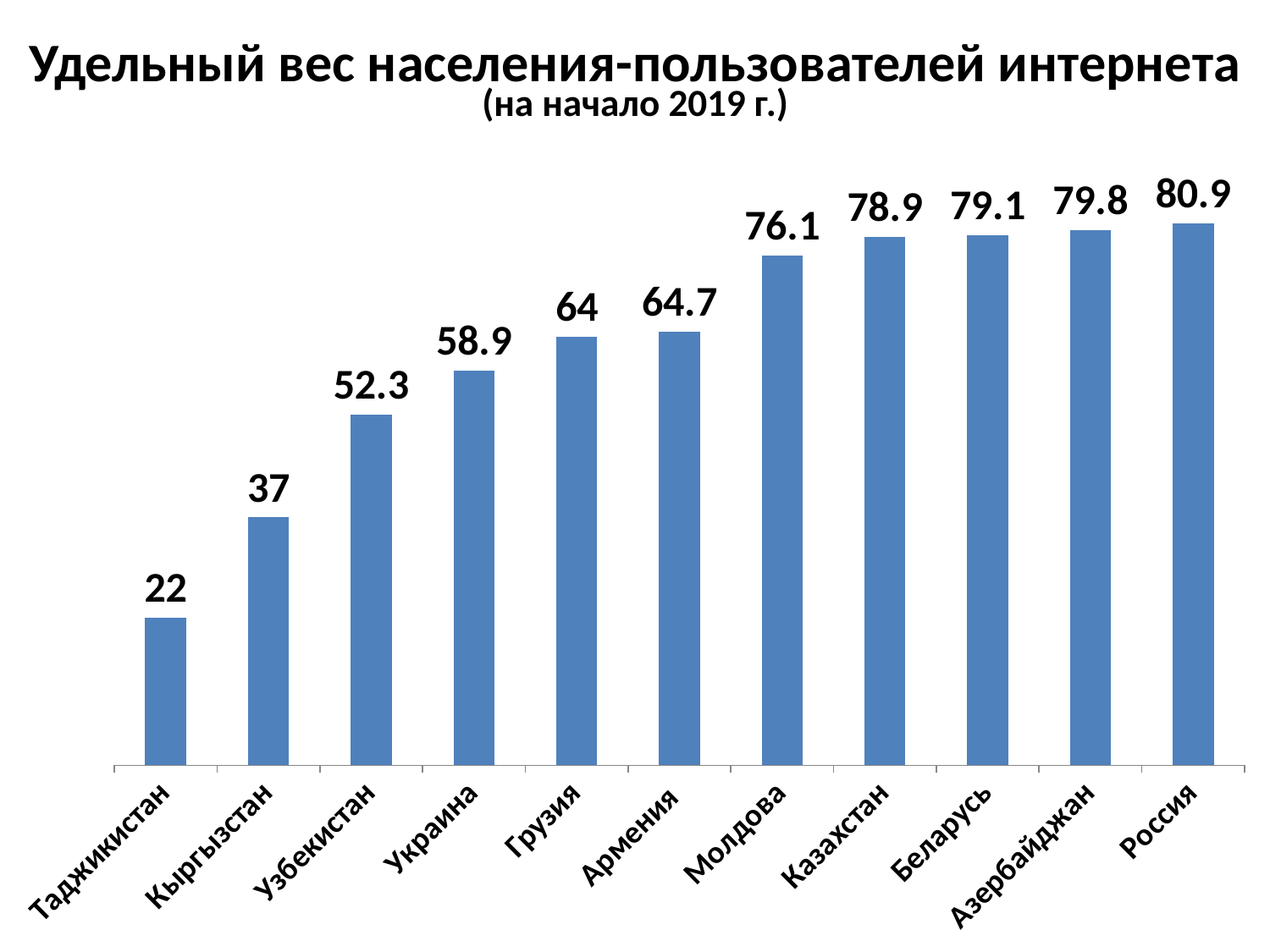
Which country has the lowest value? Таджикистан What is the difference between the values for Кыргызстан and Таджикистан? 15 What is the value for Узбекистан? 52.3 Which is larger, the value for Украина or the value for Грузия? Грузия What is the value for Армения? 64.7 What is the difference between the values for Россия and Молдова? 4.8 Which country has the highest value? Россия What is the value for Россия? 80.9 How many countries are shown on the chart? 11 Do the values rise or fall from left to right along the x axis? Rise What kind of chart is this? Bar chart What is the title of the chart? Удельный вес населения-пользователей интернета (на начало 2019 г.)